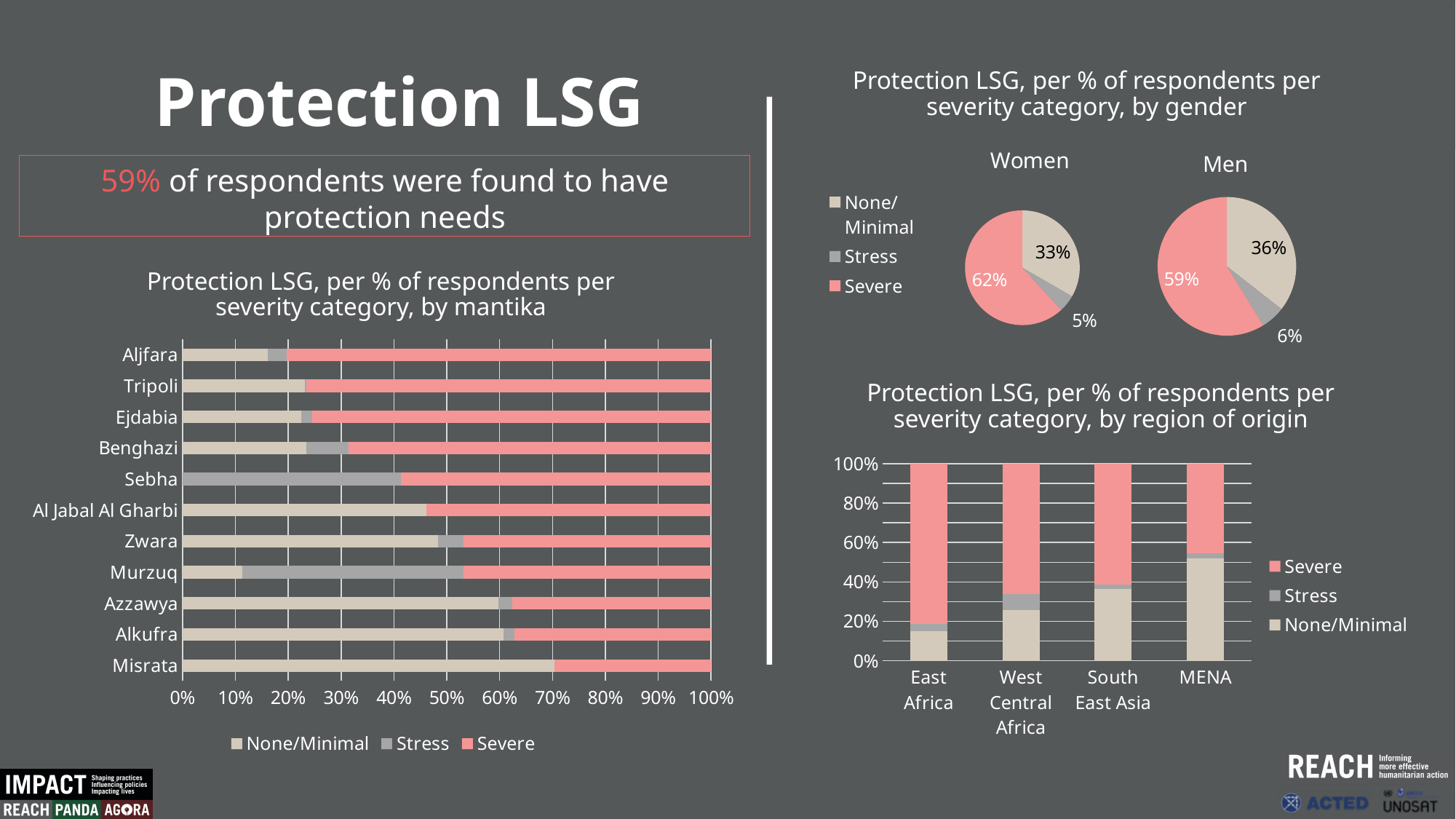
In the chart by mantika, is the None/Minimal value for Murzuq greater or less than 20%? less What kind of chart is the chart by region of origin? Stacked bar chart In the chart by mantika, how many mantikas are listed on the vertical axis? 11 In the pie chart for Women, what percentage of respondents are in the Stress category? 5% In the pie chart for Men, what percentage of respondents are in the None/Minimal category? 36% In the chart by region of origin, which region has the largest None/Minimal share? MENA In the chart by mantika, is the None/Minimal value for Misrata greater or less than 60%? greater In the pie chart for Women, what percentage of respondents are in the Severe category? 62% Comparing the Women and Men pie charts, which gender has the larger Severe share? Women In the pie chart for Men, which severity category has the smallest share? Stress What is the difference in percentage points between the Severe share for Women and the Severe share for Men in the pie charts? 3